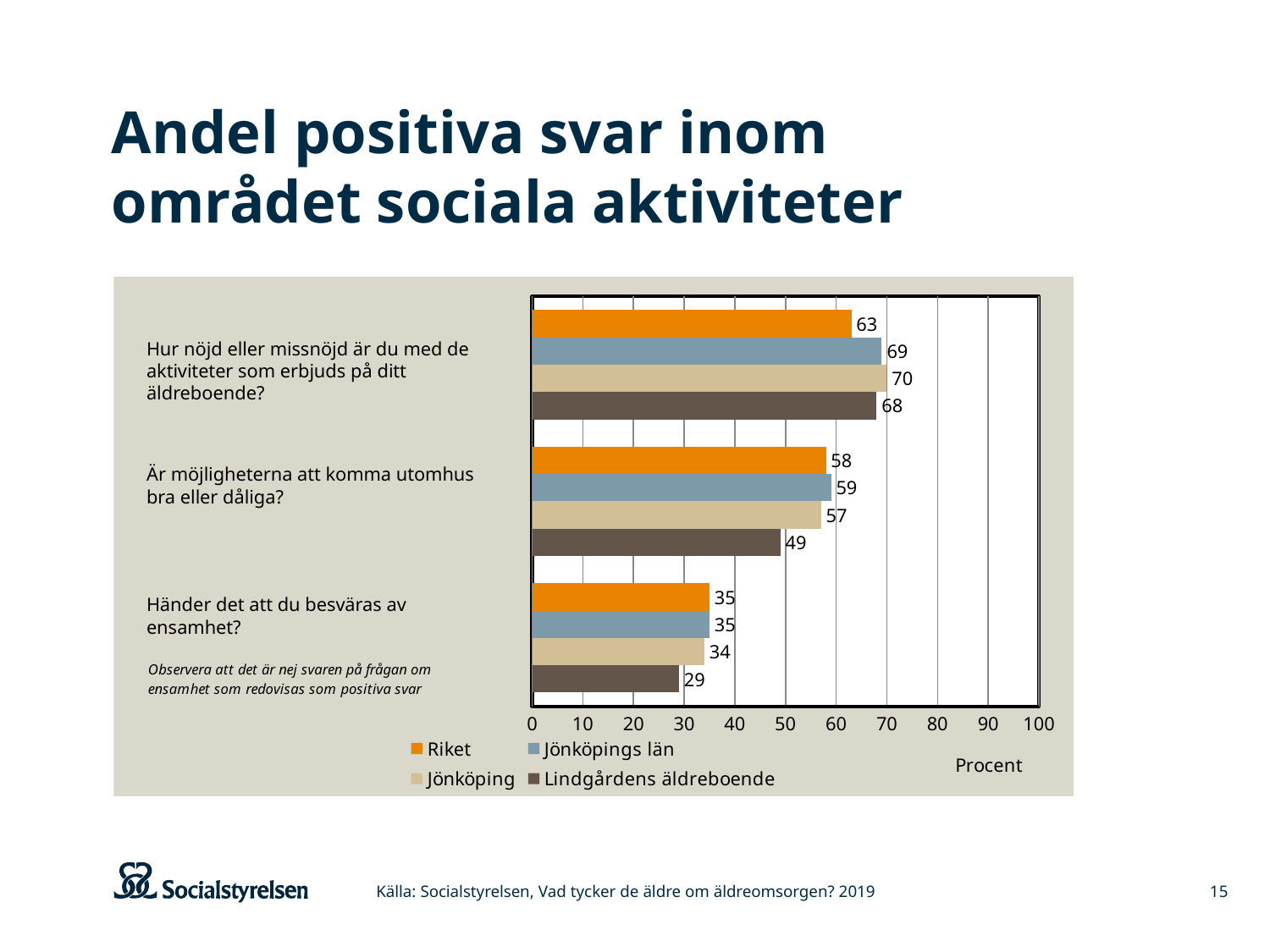
What is the difference between Jönköpings län and Lindgårdens äldreboende on the question "Är möjligheterna att komma utomhus bra eller dåliga?"? 10 Which series has the lowest value on the question "Händer det att du besväras av ensamhet?"? Lindgårdens äldreboende How many question categories are plotted on the chart? 3 What kind of chart is shown on the slide? bar chart What is the value for Riket on the question "Händer det att du besväras av ensamhet?"? 35 Which is larger on the question "Hur nöjd eller missnöjd är du med de aktiviteter som erbjuds på ditt äldreboende?": Riket or Jönköpings län? Jönköpings län What is the value for Jönköping on the question "Hur nöjd eller missnöjd är du med de aktiviteter som erbjuds på ditt äldreboende?"? 70 What unit is shown on the x axis of the chart? Procent Which series has the highest value on the question "Hur nöjd eller missnöjd är du med de aktiviteter som erbjuds på ditt äldreboende?"? Jönköping What is the value for Lindgårdens äldreboende on the question "Är möjligheterna att komma utomhus bra eller dåliga?"? 49 How many series does the legend list? 4 Is the value for Lindgårdens äldreboende on the question "Händer det att du besväras av ensamhet?" greater or less than 30? less